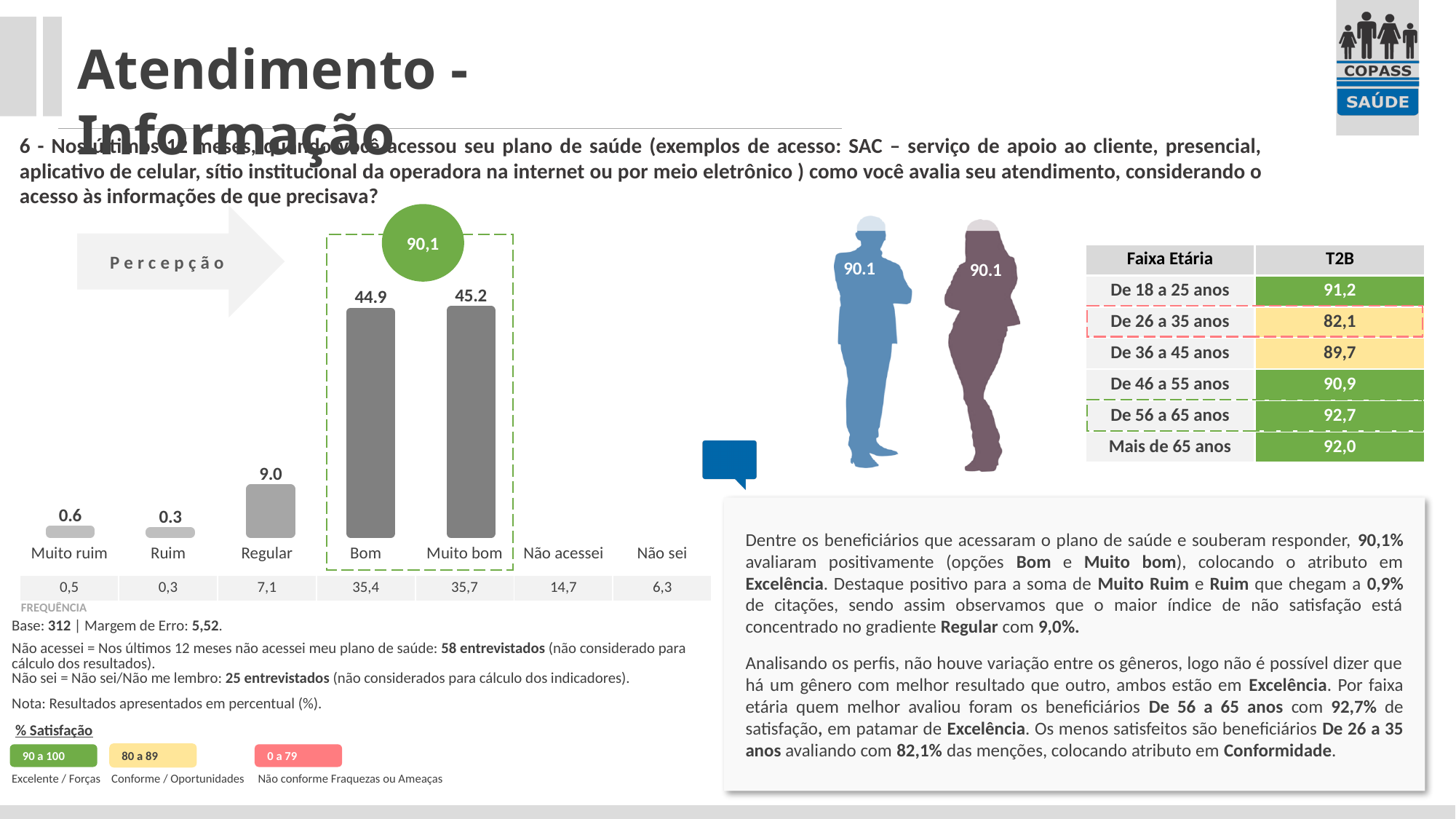
In the Percepção bar chart, which category has the highest value? Muito bom In the Faixa Etária table, which age group has the highest T2B value? De 56 a 65 anos In the Percepção bar chart, what is the value for Bom? 44.9 In the Percepção bar chart, what is the value for Regular? 9.0 In the Percepção bar chart, what is the difference between the values for Muito bom and Bom? 0.3 In the Percepção bar chart, what is the difference between the values for Regular and Ruim? 8.7 In the Faixa Etária table, what is the T2B value for De 26 a 35 anos? 82,1 In the Percepção bar chart, what is the value for Muito ruim? 0.6 What type of chart is used to show the Percepção ratings (Muito ruim to Muito bom)? bar chart In the Percepção bar chart, which category has the lowest value? Ruim In the Percepção bar chart, what is the combined value of Bom and Muito bom shown in the green circle? 90,1 In the Percepção bar chart, which is larger, the value for Regular or the value for Muito ruim? Regular